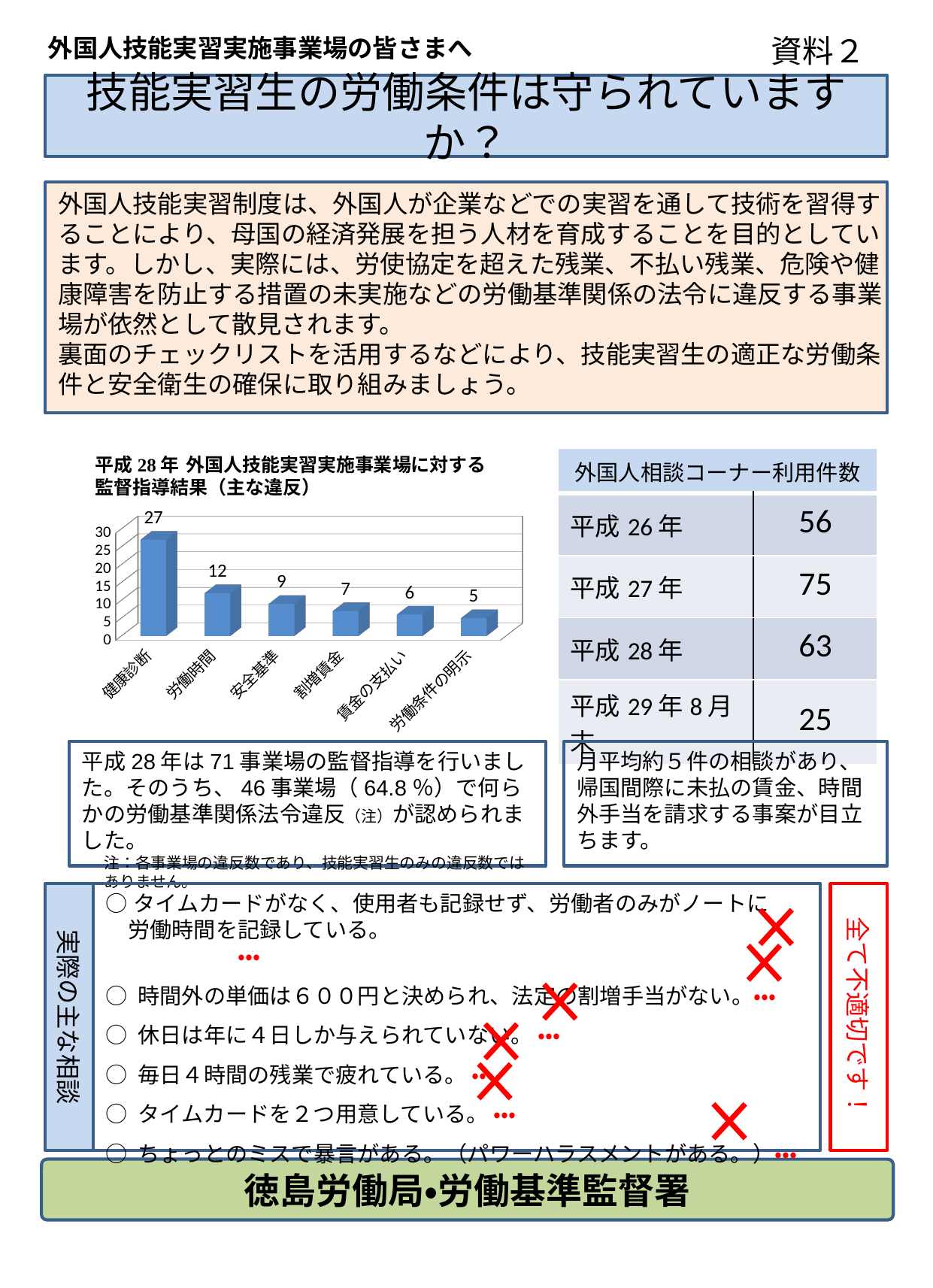
Which category has the highest value in the chart? 健康診断 What is the value for 健康診断 in the chart? 27 What is the value for 安全基準 in the chart? 9 What is the value for 労働時間 in the chart? 12 What kind of chart is shown on the slide? bar chart How many categories are shown in the chart? 6 What is the difference between the values for 健康診断 and 労働時間? 15 Which category has the lowest value in the chart? 労働条件の明示 Is the value for 健康診断 greater or less than 25? greater Do the values rise or fall from left to right across the categories in the chart? fall What is the value for 労働条件の明示 in the chart? 5 Which is larger, the value for 割増賃金 or the value for 賃金の支払い? 割増賃金